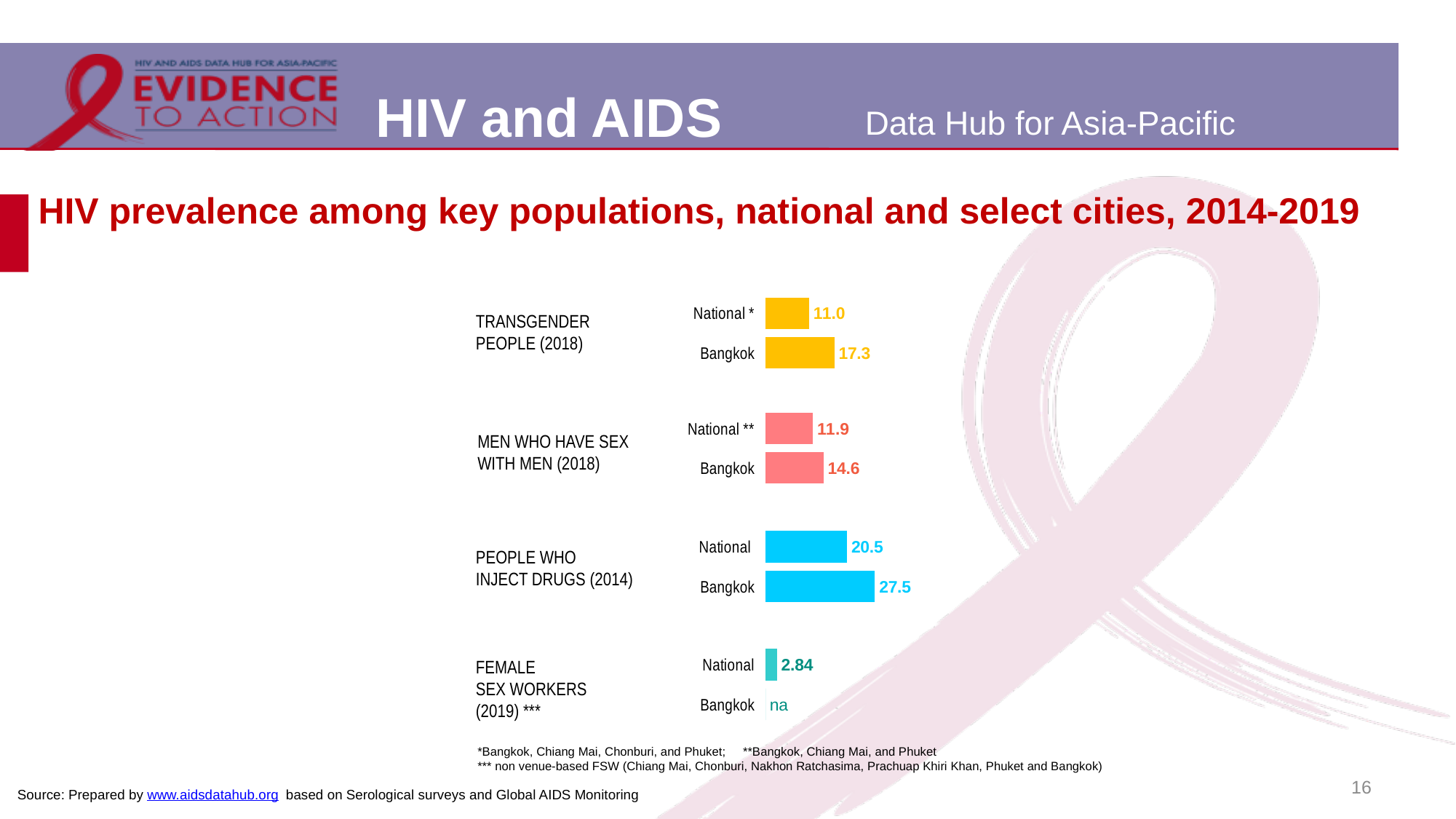
What is the HIV prevalence among men who have sex with men in Bangkok (2018)? 14.6 How many key population groups are shown in the chart? 4 Which is larger: the national HIV prevalence among transgender people or among men who have sex with men? Men who have sex with men (11.9) Which key population has the lowest national HIV prevalence? Female sex workers (2019) What is the difference between the Bangkok and national HIV prevalence among people who inject drugs (2014)? 7.0 What is the national HIV prevalence among transgender people (2018)? 11.0 What value is shown for female sex workers in Bangkok? na What is the national HIV prevalence among female sex workers (2019)? 2.84 What type of chart is used on the slide? Bar chart What is the difference between the Bangkok and national HIV prevalence among transgender people (2018)? 6.3 Which key population has the highest HIV prevalence in Bangkok? People who inject drugs (2014) What is the national HIV prevalence among people who inject drugs (2014)? 20.5